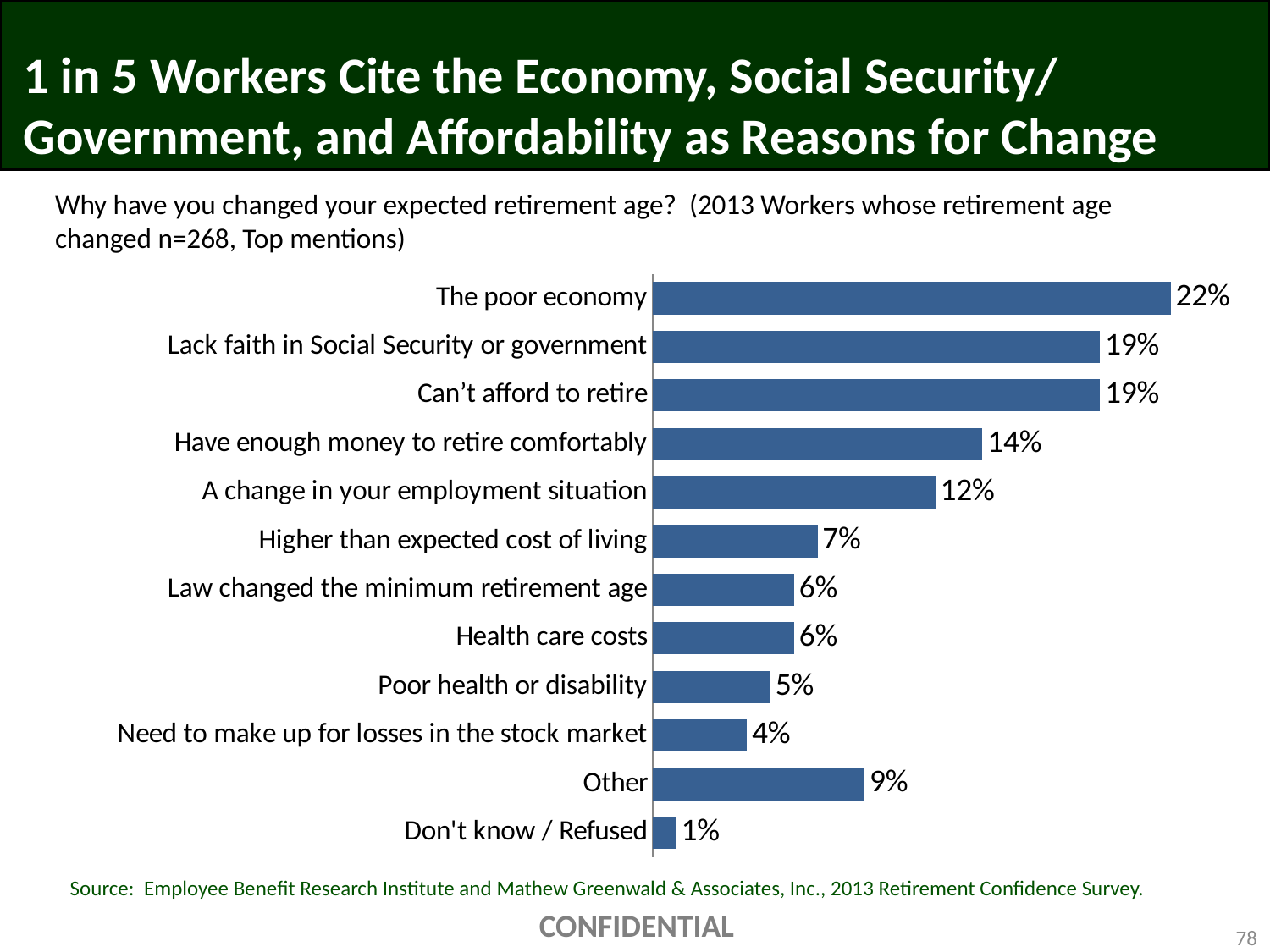
What is the difference between the value for "Higher than expected cost of living" and the value for "Poor health or disability"? 2% How many categories (bars) are shown on the chart? 12 What is the difference between the percentage for "The poor economy" and the percentage for "Can't afford to retire"? 3% What percentage of workers cited the poor economy as a reason for changing their expected retirement age? 22% Which category has the lowest percentage on the chart? Don't know / Refused What is the value for "Have enough money to retire comfortably"? 14% Which is larger: the value for "A change in your employment situation" or the value for "Other"? A change in your employment situation What is the sample size (n) stated in the chart's subtitle? n=268 What percentage is shown for "Need to make up for losses in the stock market"? 4% What percentage of workers said they lack faith in Social Security or government? 19% Which reason has the highest percentage on the chart? The poor economy What kind of chart is shown on the slide? Bar chart